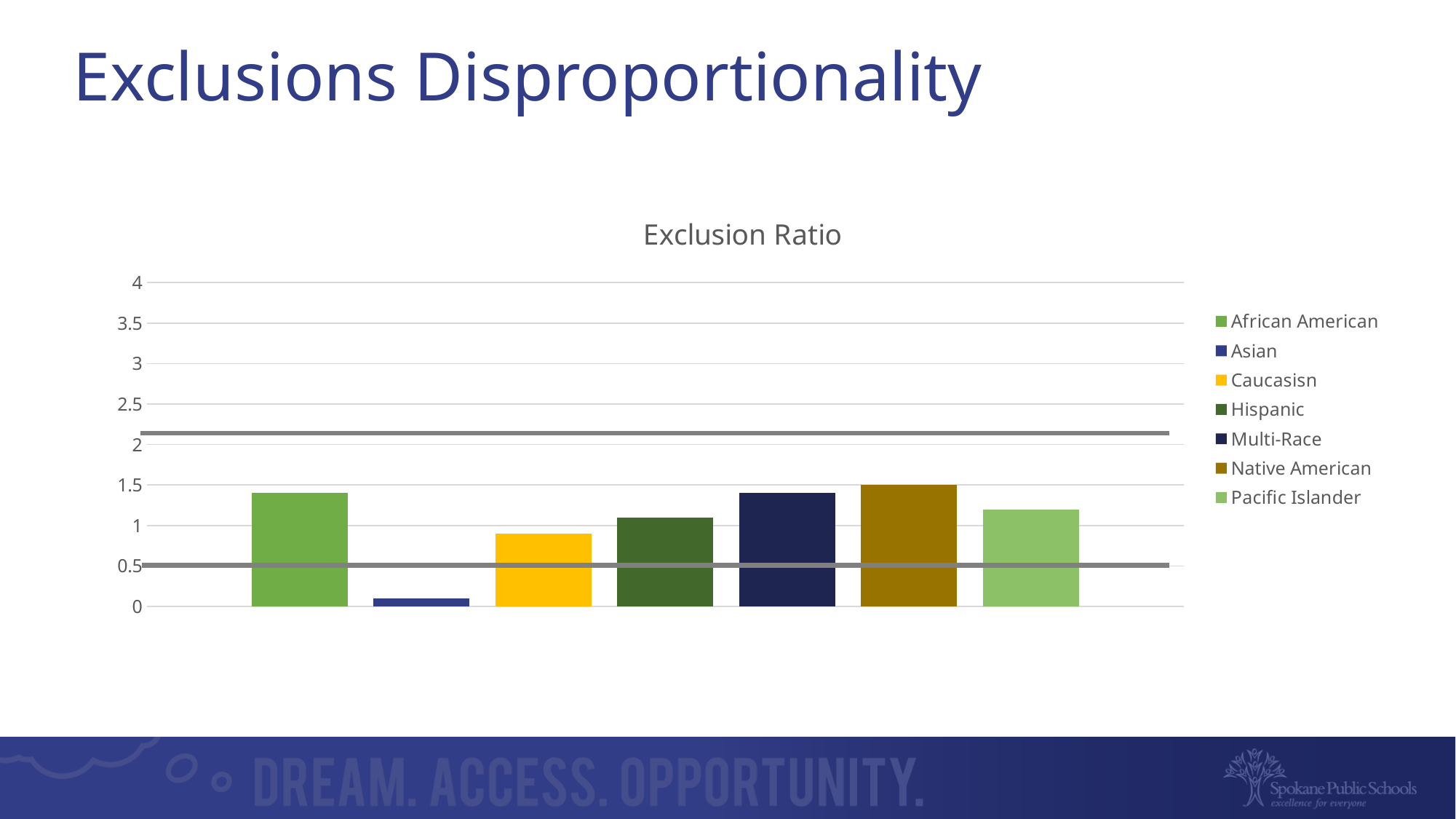
Is the value for Native American greater or less than 1? greater What colour is the bar for Caucasisn? yellow How many bars are plotted in the chart? 7 How many entries does the chart's legend list? 7 Is the value for Caucasisn greater or less than 1? less Is the value for Asian greater or less than 0.5? less What kind of chart is shown on the slide? bar chart Which has the larger exclusion ratio, Caucasisn or Hispanic? Hispanic What is the title of the chart? Exclusion Ratio Which group has the highest exclusion ratio? Native American Which group has the lowest exclusion ratio? Asian